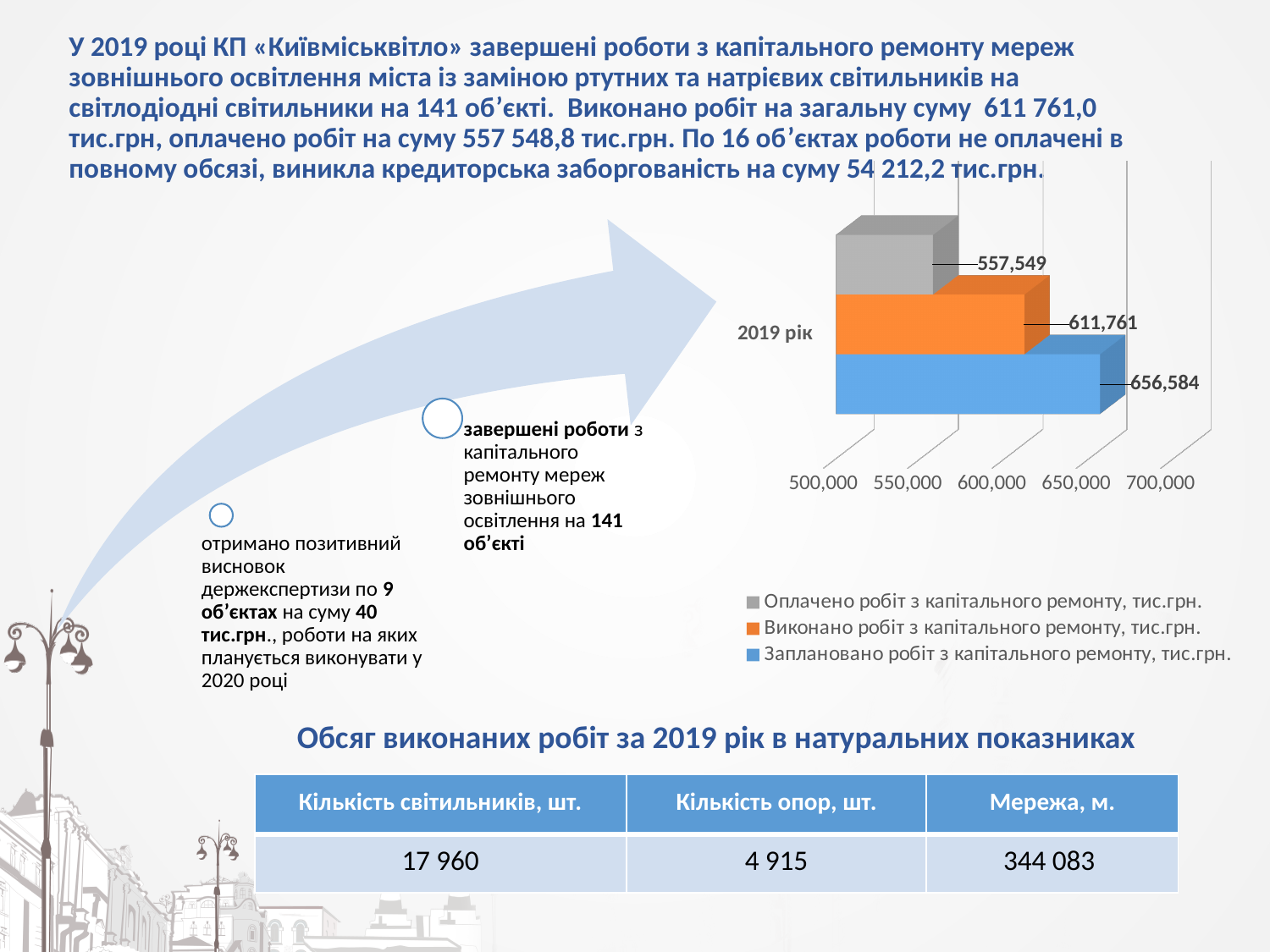
What is the value for 'Виконано робіт з капітального ремонту, тис.грн.' in 2019 рік? 611,761 Which is larger: the value for Виконано робіт or the value for Оплачено робіт? Виконано робіт What is the value for 'Оплачено робіт з капітального ремонту, тис.грн.' in 2019 рік? 557,549 Is the value for Оплачено робіт greater or less than 600,000? less What kind of chart is shown on the slide? bar chart What is the difference between the completed (Виконано) and paid (Оплачено) values? 54,212 Which series has the lowest value in the chart? Оплачено робіт з капітального ремонту, тис.грн. What is the value for 'Заплановано робіт з капітального ремонту, тис.грн.' in 2019 рік? 656,584 How many series does the legend list? 3 Which series has the highest value in the chart? Заплановано робіт з капітального ремонту, тис.грн. What colour is the bar for Заплановано робіт з капітального ремонту? blue What is the difference between the planned (Заплановано) and completed (Виконано) values? 44,823